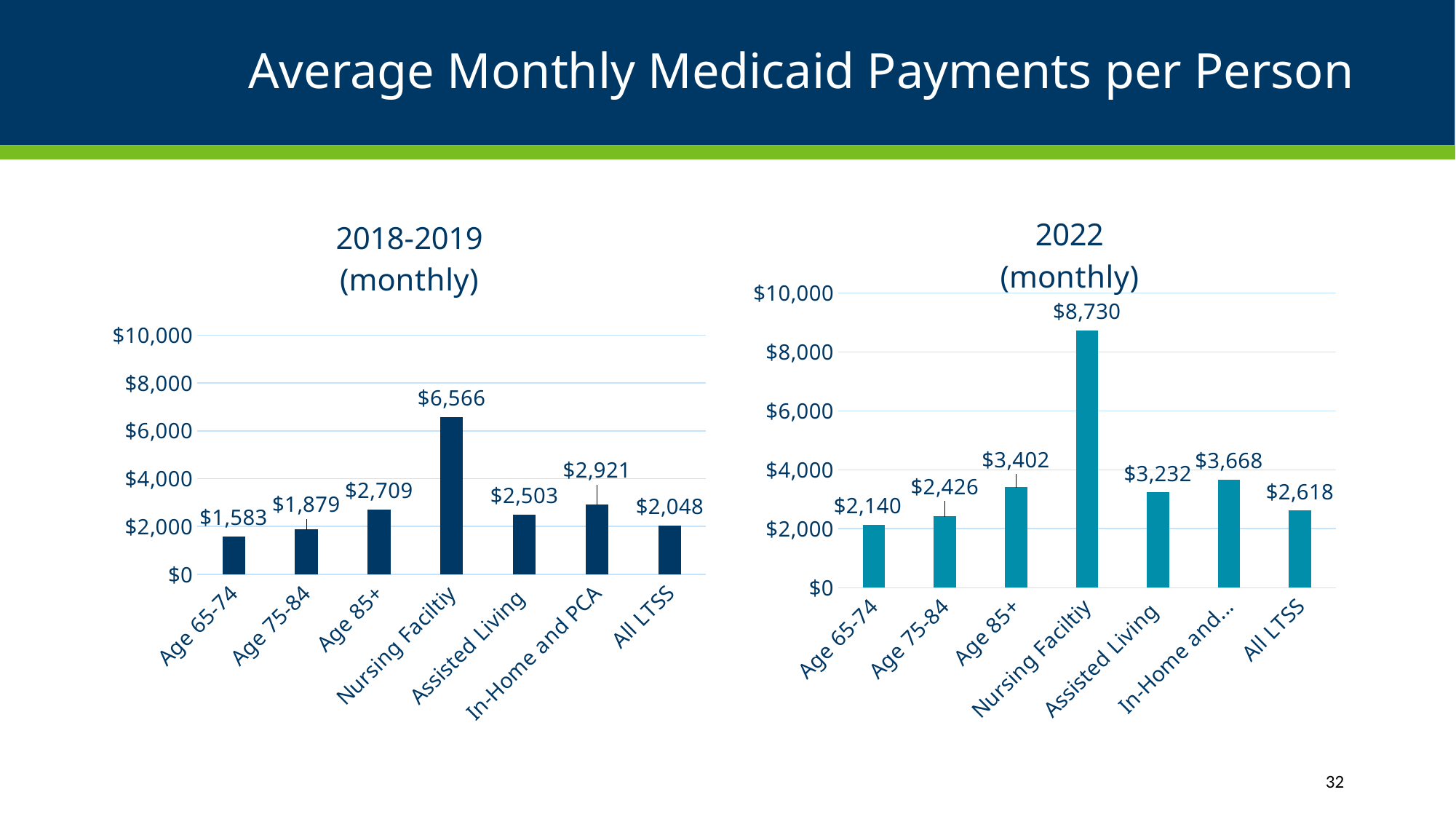
In the 2018-2019 (monthly) chart, which category has the lowest value? Age 65-74 In the 2022 (monthly) chart, what is the value for All LTSS? $2,618 In the 2018-2019 (monthly) chart, which is larger: the value for In-Home and PCA or the value for Assisted Living? In-Home and PCA In the 2018-2019 (monthly) chart, what is the value for Nursing Faciltiy? $6,566 What is the title of the slide? Average Monthly Medicaid Payments per Person In the 2022 (monthly) chart, what is the difference between the values for Age 75-84 and Age 65-74? $286 What kind of chart is the 2022 (monthly) chart? bar chart In the 2018-2019 (monthly) chart, what is the difference between the values for Nursing Faciltiy and Assisted Living? $4,063 How many categories are shown in the 2018-2019 (monthly) chart? 7 In the 2022 (monthly) chart, what is the value for Age 85+? $3,402 In the 2022 (monthly) chart, which category has the highest value? Nursing Faciltiy In the 2022 (monthly) chart, is the value for Nursing Faciltiy greater or less than $8,000? greater